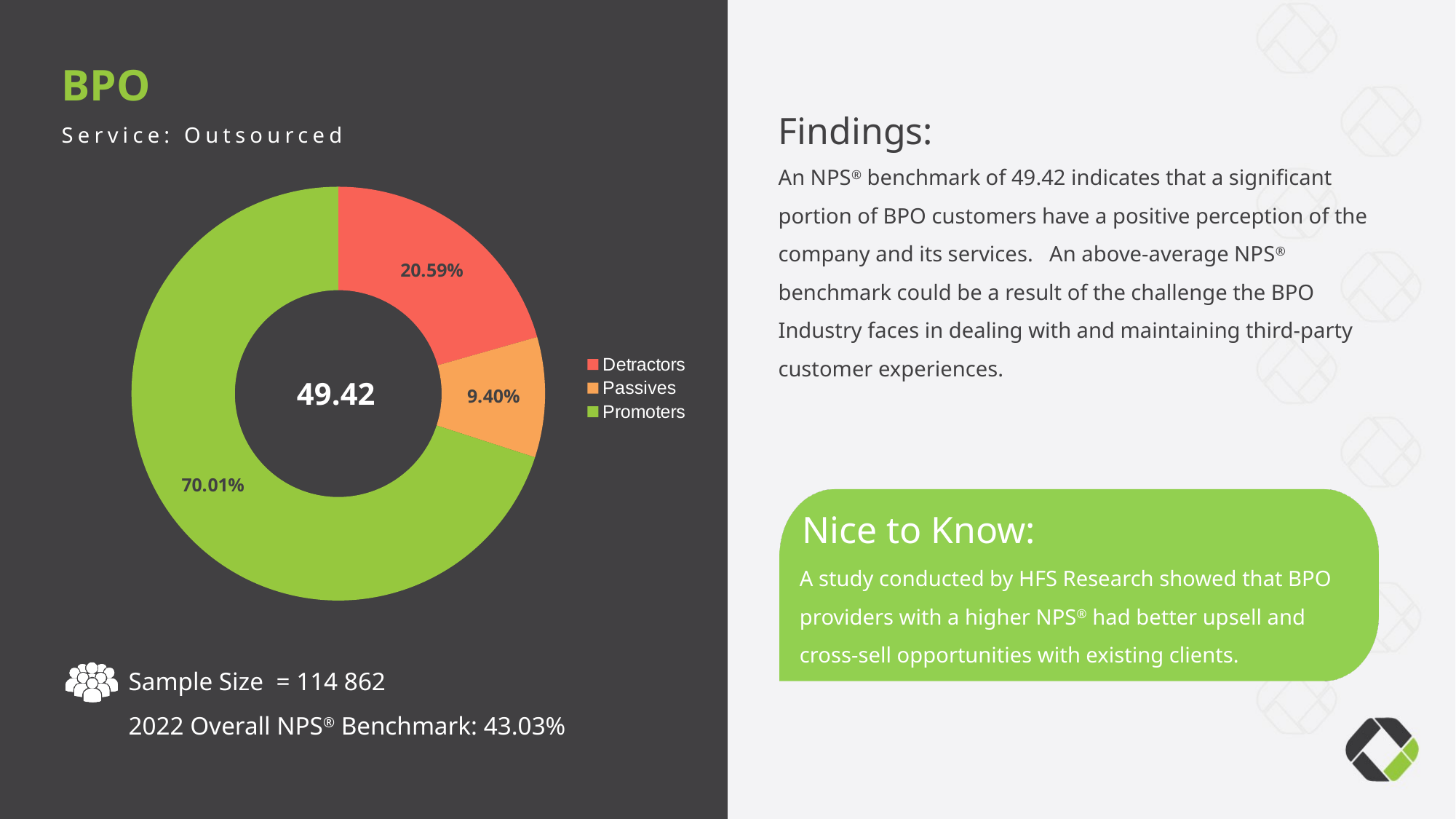
What percentage of the donut chart is Passives? 9.40% Which category has the largest share of the donut chart? Promoters What colour represents Promoters in the chart legend? Green What percentage of the donut chart is Promoters? 70.01% Which is larger, the Detractors share or the Passives share? Detractors How many categories does the donut chart show? 3 What is the difference in percentage points between Promoters and Detractors? 49.42 What kind of chart is shown on the slide? Donut (pie) chart What number is displayed in the centre of the donut chart? 49.42 What is the combined share of Detractors and Passives? 29.99% Which category has the smallest share of the donut chart? Passives What percentage of the donut chart is Detractors? 20.59%